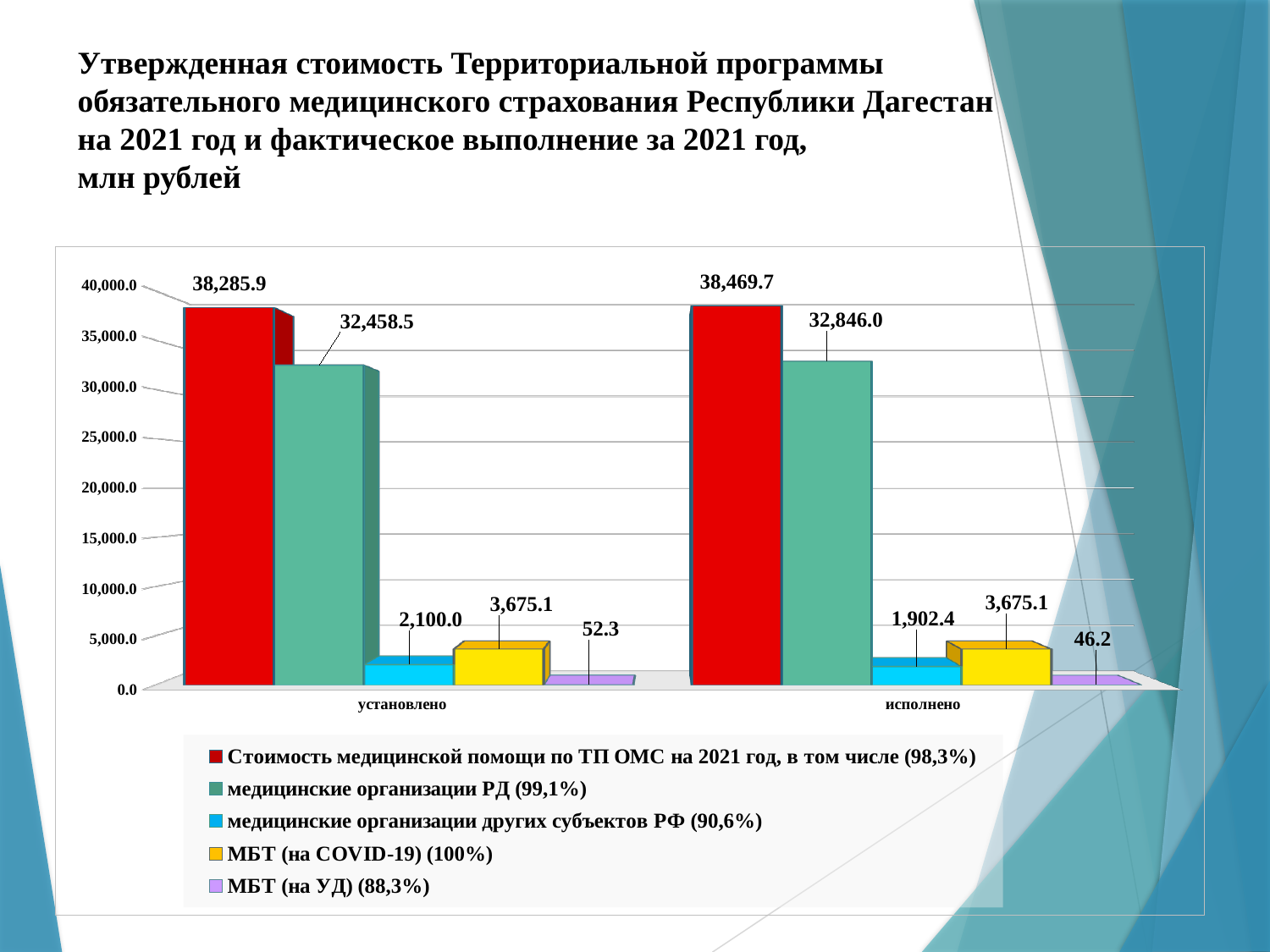
What kind of chart is shown on the slide? Bar chart What is the difference between the «установлено» and «исполнено» values for «медицинские организации других субъектов РФ (90,6%)»? 197.6 What is the value for «Стоимость медицинской помощи по ТП ОМС на 2021 год, в том числе (98,3%)» in the «установлено» category? 38,285.9 What is the difference between the «исполнено» and «установлено» values for «Стоимость медицинской помощи по ТП ОМС на 2021 год, в том числе (98,3%)»? 183.8 How many categories are shown on the x axis? 2 Which is larger for «медицинские организации РД (99,1%)»: the «установлено» value or the «исполнено» value? исполнено Which series has the highest value in the «исполнено» category? Стоимость медицинской помощи по ТП ОМС на 2021 год, в том числе (98,3%) What is the value for «медицинские организации РД (99,1%)» in the «исполнено» category? 32,846.0 What is the value for «медицинские организации других субъектов РФ (90,6%)» in the «установлено» category? 2,100.0 Which series has the lowest value in the «установлено» category? МБТ (на УД) (88,3%) How many series does the legend list? 5 What is the value for «МБТ (на УД) (88,3%)» in the «исполнено» category? 46.2